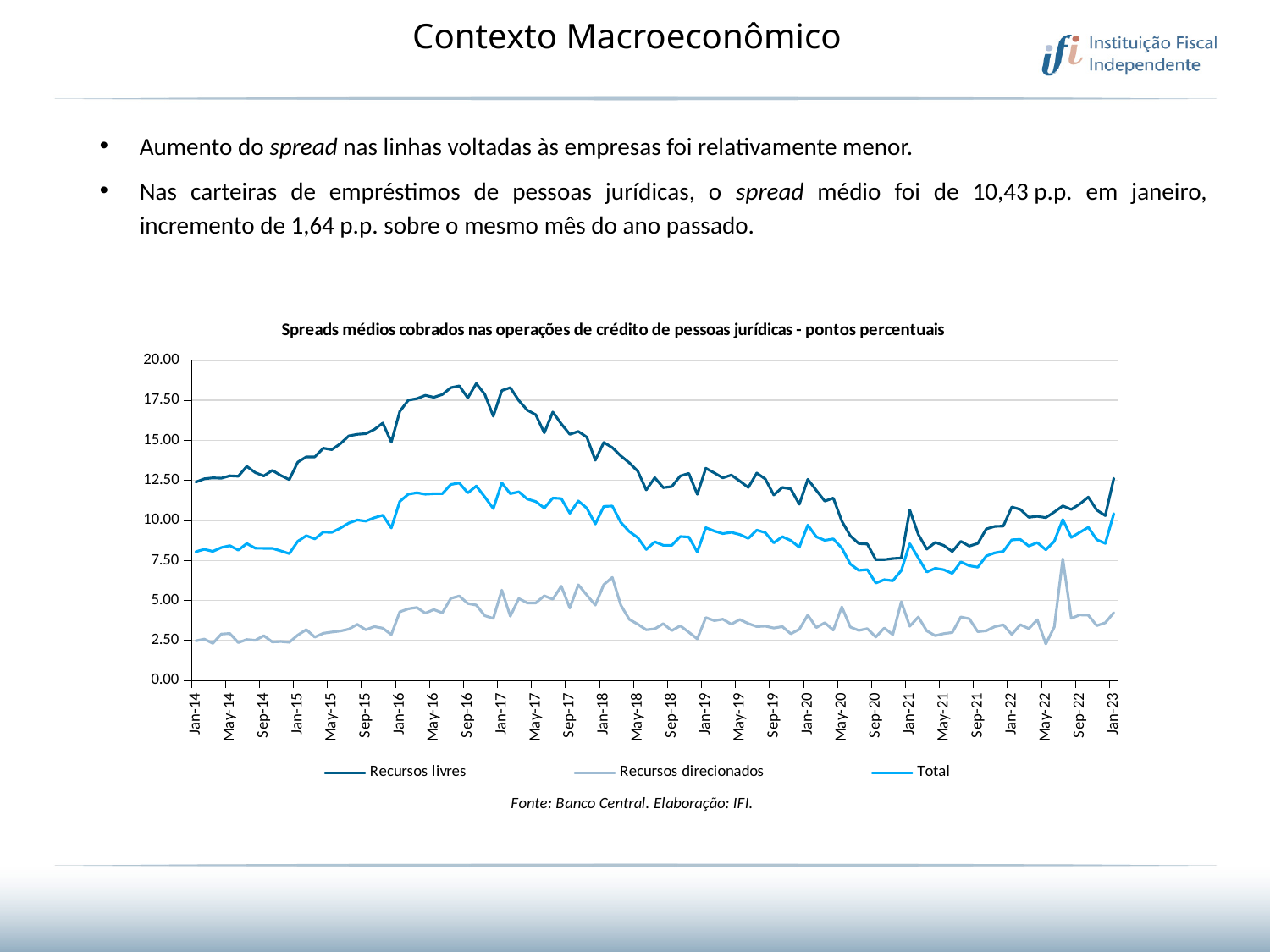
Which series in the chart has the lowest values across the whole period? Recursos direcionados Is the value of Recursos livres in Sep-20 greater or less than 10.00? less Is the value of Recursos livres in Jan-14 greater or less than 10.00? greater What kind of chart is shown on the slide? line chart What is the title of the chart? Spreads médios cobrados nas operações de crédito de pessoas jurídicas - pontos percentuais Is the value of Recursos direcionados in Jan-18 greater or less than 5.00? greater Does the Recursos livres series rise or fall between Jan-14 and Sep-16? rise How many series does the legend of the chart list? 3 In Jan-16, which is larger: Recursos livres or Recursos direcionados? Recursos livres Which series in the chart has the highest values across the whole period? Recursos livres